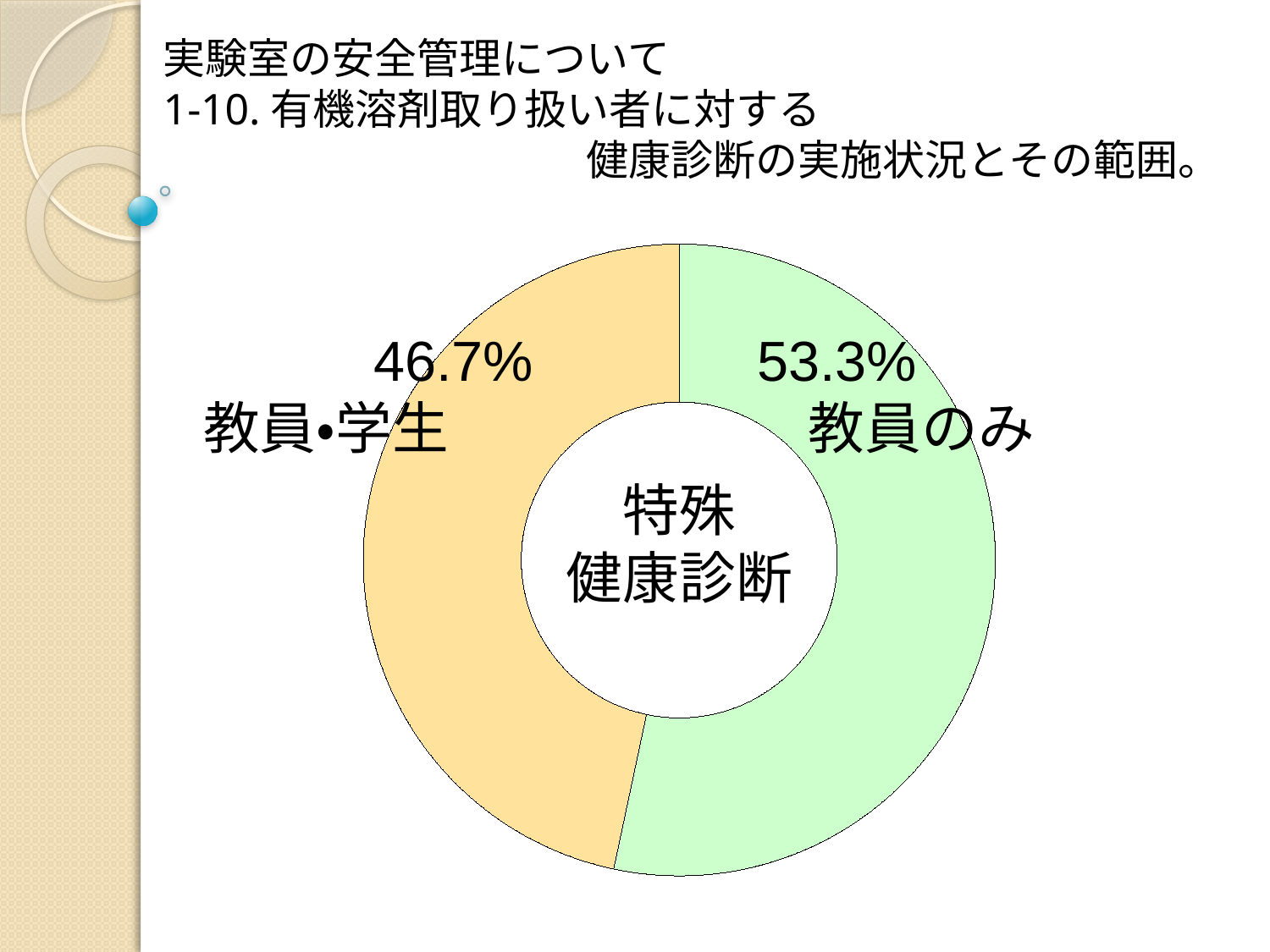
What colour is the 教員のみ segment of the chart? green Is the share for 教員•学生 greater or less than 50%? less Is the share for 教員のみ larger or smaller than the share for 教員•学生? larger What percentage of the doughnut chart is labelled 教員•学生? 46.7% Which category has the smaller share in the chart? 教員•学生 What text appears in the centre of the doughnut chart? 特殊健康診断 How many categories are shown in the chart? 2 What percentage of the doughnut chart is labelled 教員のみ? 53.3% What kind of chart is shown on the slide? doughnut chart What is the difference in percentage points between 教員のみ and 教員•学生? 6.6 Which category has the larger share in the chart? 教員のみ